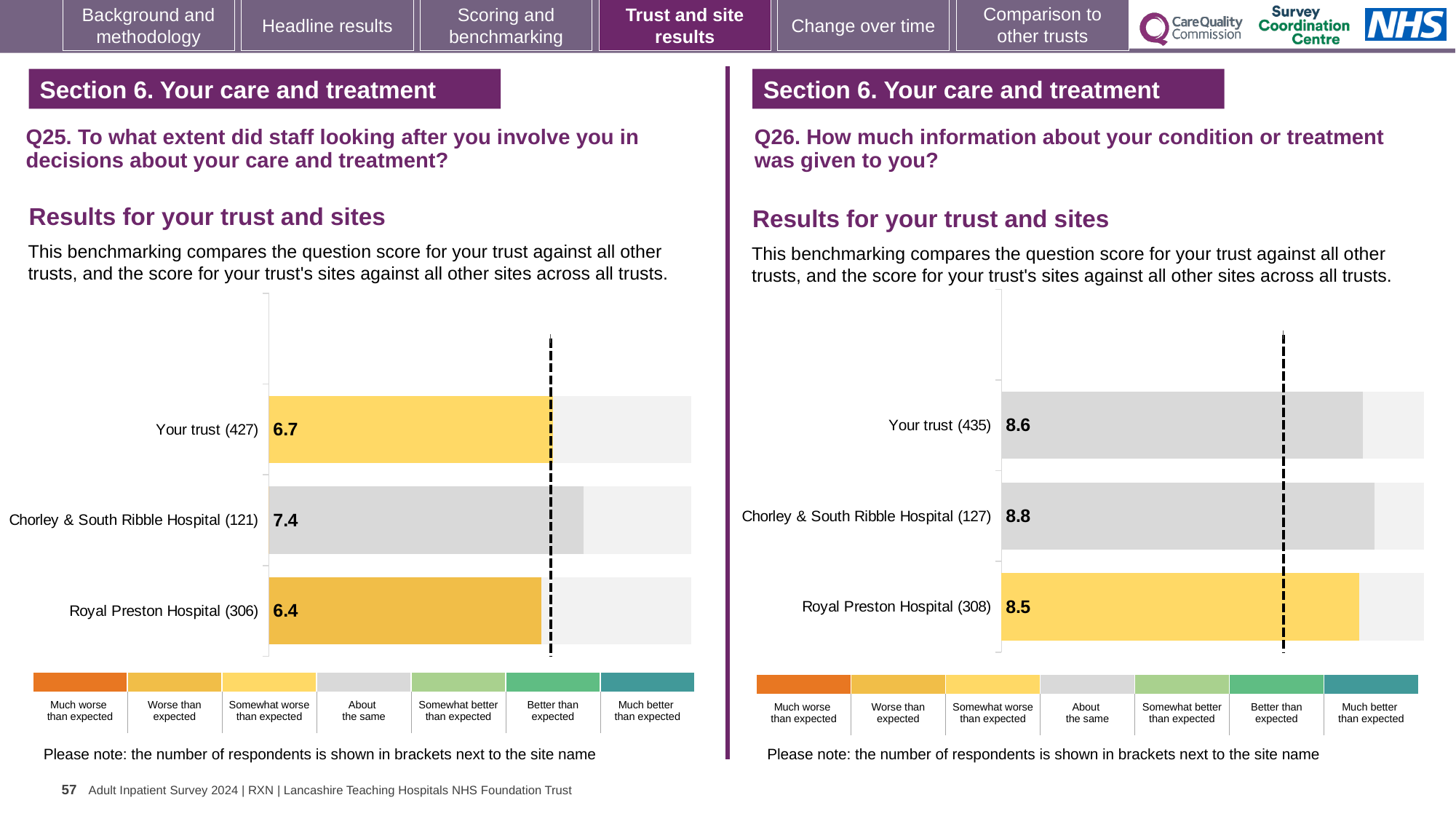
In the Q25 chart on the left, what is the score for Your trust (427)? 6.7 In the Q25 chart on the left, what is the score for Chorley & South Ribble Hospital (121)? 7.4 How many bars are plotted in the Q25 chart on the left? 3 In the Q25 chart on the left, what is the difference between the scores for Chorley & South Ribble Hospital and Royal Preston Hospital? 1.0 In the Q26 chart on the right, what is the score for Royal Preston Hospital (308)? 8.5 What type of chart is used for the Q26 results on the right? Bar chart In the Q26 chart on the right, what is the difference between the scores for Chorley & South Ribble Hospital and Your trust? 0.2 In the Q26 chart on the right, what is the score for Your trust (435)? 8.6 In the Q26 chart on the right, what is the score for Chorley & South Ribble Hospital (127)? 8.8 In the Q25 chart on the left, which site or trust has the highest score? Chorley & South Ribble Hospital (121) In the Q25 chart on the left, what is the score for Royal Preston Hospital (306)? 6.4 In the Q25 chart on the left, which site or trust has the lowest score? Royal Preston Hospital (306)